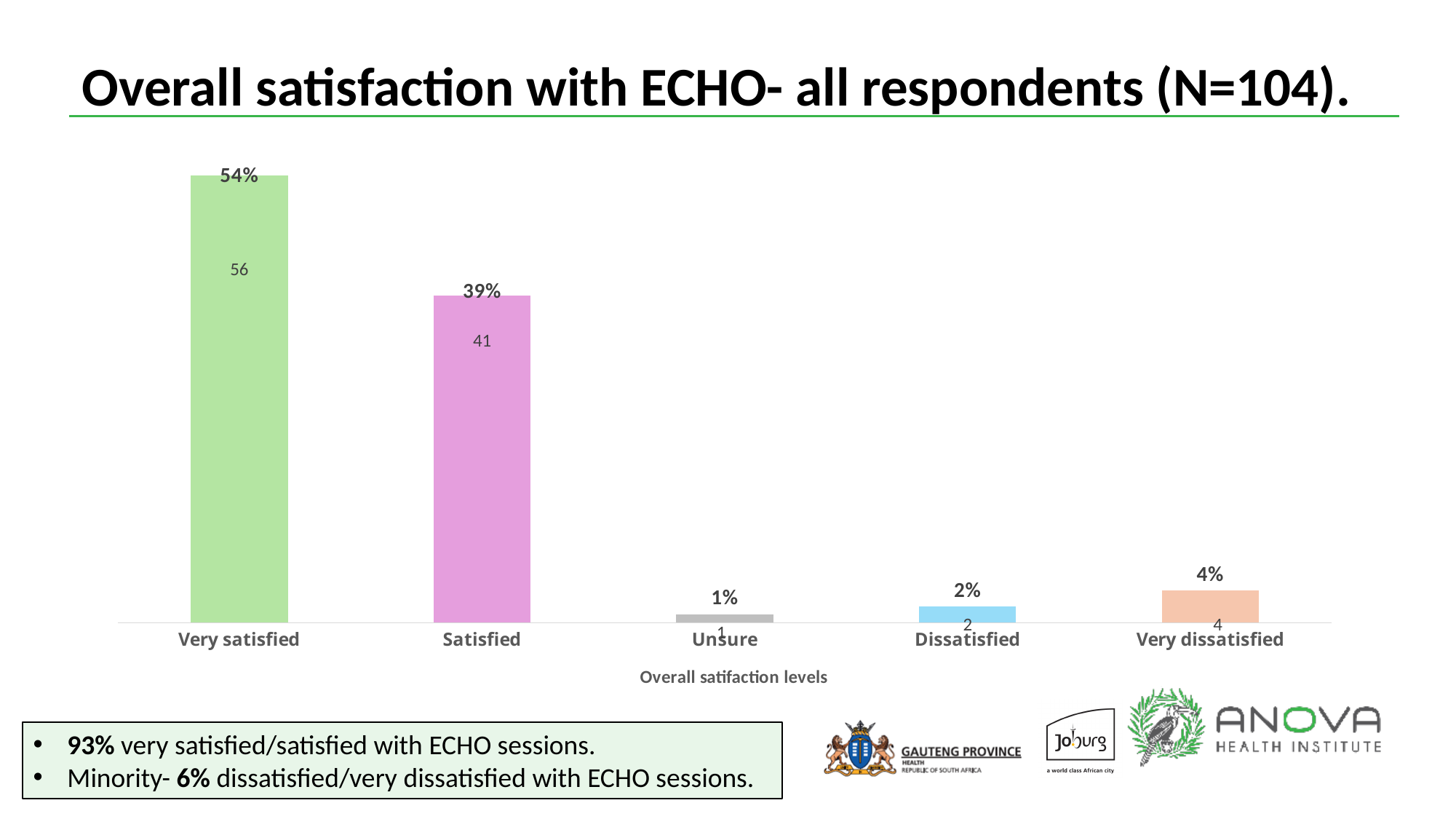
What percentage of respondents were Unsure? 1% How many satisfaction levels are shown on the x axis? 5 Which satisfaction level has the highest percentage? Very satisfied What kind of chart is shown on the slide? Bar chart What colour is the bar for Satisfied? Purple What is the x-axis title of the chart? Overall satifaction levels What percentage of respondents were Satisfied? 39% How many respondents were Very dissatisfied (count shown on the bar)? 4 Which satisfaction level has the lowest percentage? Unsure Which is larger, the percentage for Dissatisfied or for Very dissatisfied? Very dissatisfied What percentage of respondents were Very satisfied? 54% What is the difference in percentage points between Very satisfied and Satisfied? 15%